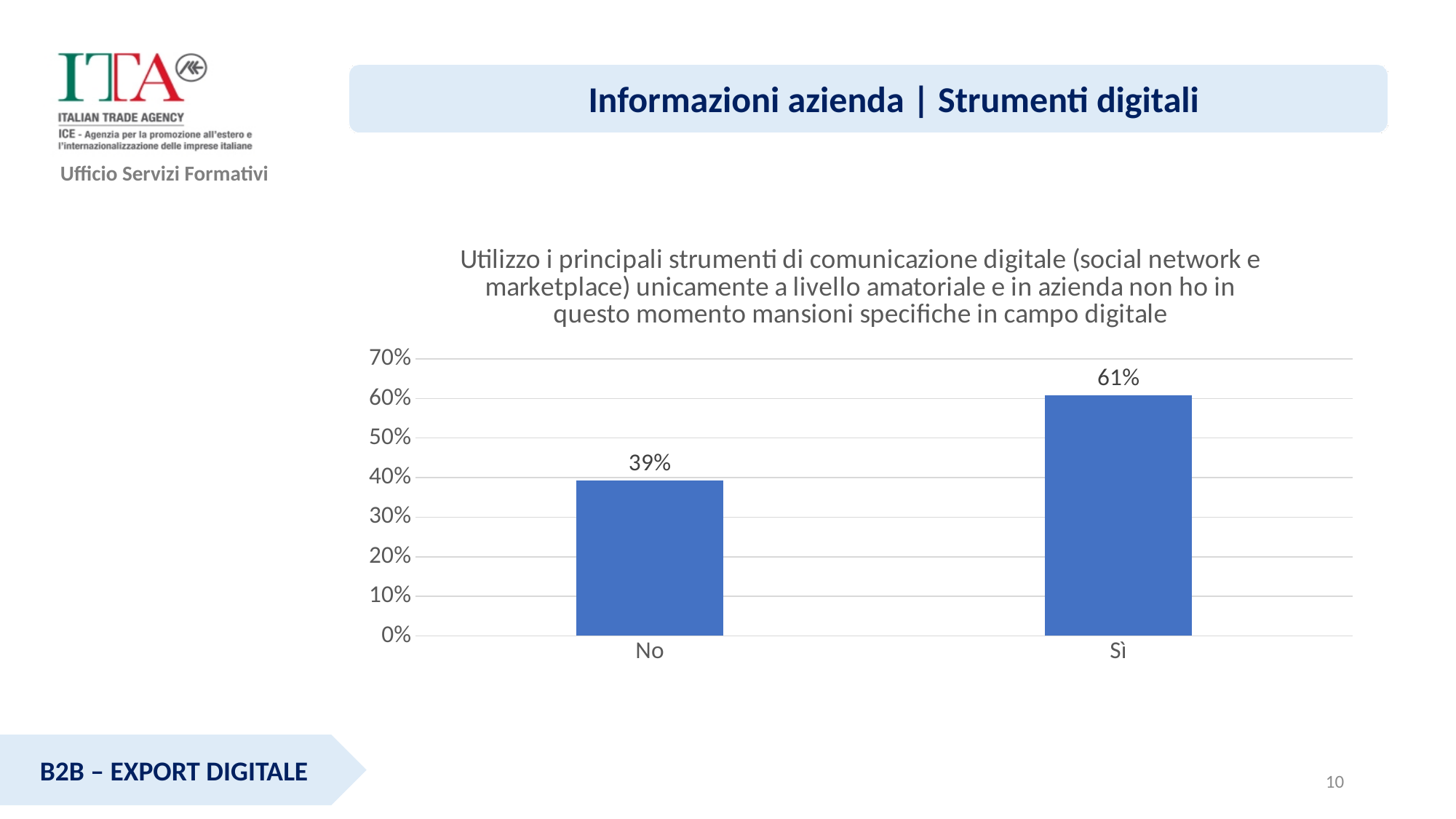
Is the value for "Sì" greater or less than 50%? greater Which category has the lowest value? No Which category has the highest value? Sì How many categories are shown on the x axis? 2 Which is larger, the value for "No" or the value for "Sì"? Sì Is the value for "No" greater or less than 40%? less What is the value for "Sì"? 61% What colour are the bars in the chart? blue What is the value for "No"? 39% What is the difference between the values for "Sì" and "No"? 22% What is the highest value shown on the y axis? 70% What kind of chart is shown on the slide? bar chart